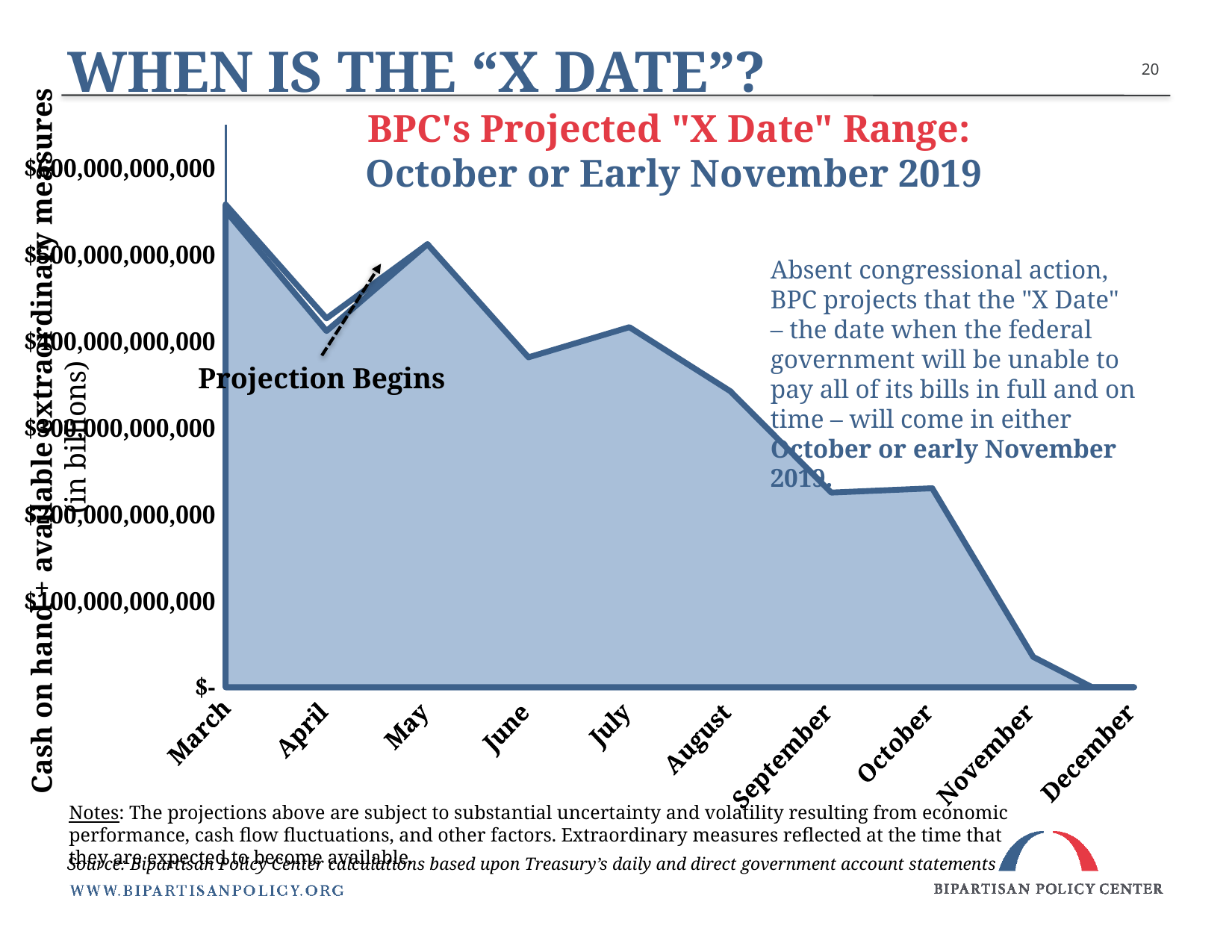
Overall, do the values rise or fall from March to December? Fall Which is larger, the value for March or the value for November? March Is the value for May greater or less than $400,000,000,000? greater Is the value for September greater or less than $300,000,000,000? less Which month has the lowest value on the chart? December How many months are labeled on the x axis of the chart? 10 What is the title of the chart? BPC's Projected "X Date" Range: October or Early November 2019 Is the value for March greater or less than $500,000,000,000? greater What kind of chart is shown on the slide? Area chart What does the annotation with the dashed arrow near April say? Projection Begins Which month has the highest value of cash on hand plus extraordinary measures? March